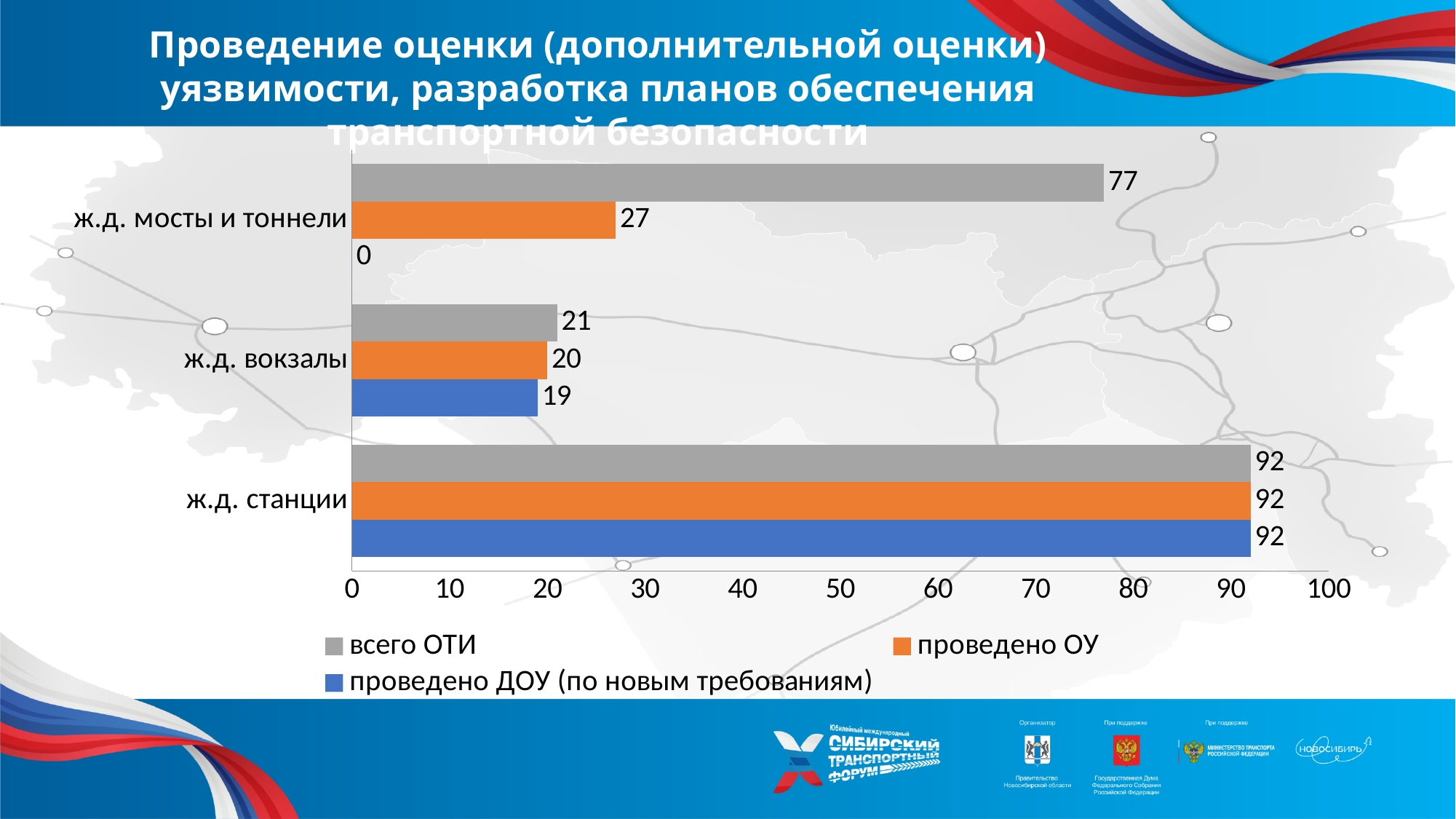
How many categories are shown on the chart? 3 What is the value of 'проведено ДОУ (по новым требованиям)' for 'ж.д. станции'? 92 What is the value of 'проведено ОУ' for 'ж.д. вокзалы'? 20 What is the value of 'всего ОТИ' for 'ж.д. мосты и тоннели'? 77 Is the value of 'всего ОТИ' for 'ж.д. мосты и тоннели' greater or less than 70? greater What type of chart is shown on the slide? bar chart Which category has the lowest value for 'проведено ОУ'? ж.д. вокзалы What is the value of 'проведено ДОУ (по новым требованиям)' for 'ж.д. мосты и тоннели'? 0 Which category has the highest value for 'всего ОТИ'? ж.д. станции Which is larger for 'ж.д. вокзалы': 'всего ОТИ' or 'проведено ДОУ (по новым требованиям)'? всего ОТИ What is the difference between 'всего ОТИ' and 'проведено ОУ' for 'ж.д. мосты и тоннели'? 50 How many series does the legend list? 3